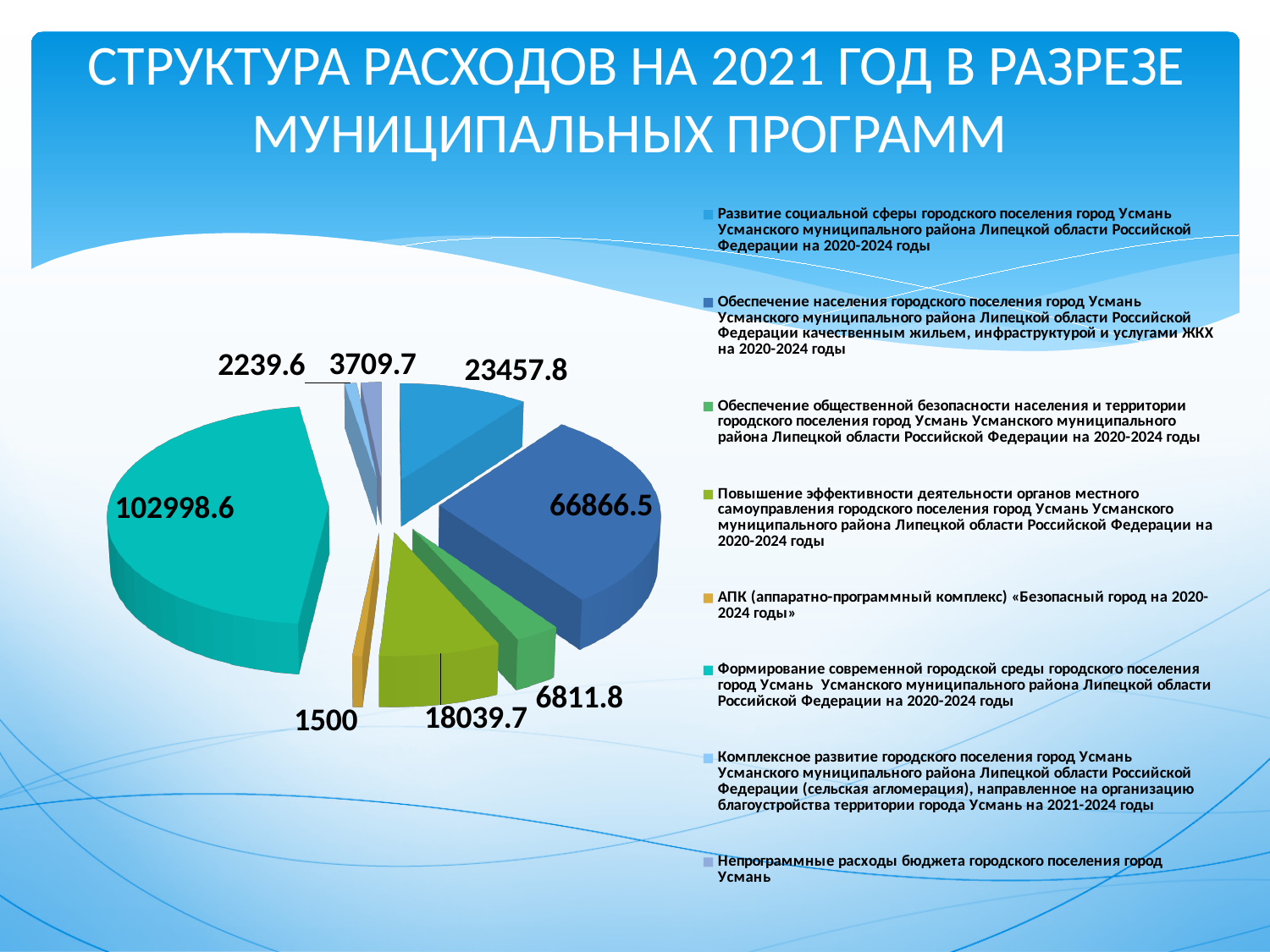
How many entries does the legend list? 8 What is the difference between the largest value (102998.6) and the second largest value (66866.5)? 36132.1 What is the value for «Развитие социальной сферы городского поселения город Усмань ... на 2020-2024 годы»? 23457.8 What type of chart is shown on the slide? Pie chart How many slices does the pie chart have? 8 What is the value for «Формирование современной городской среды городского поселения город Усмань ... на 2020-2024 годы»? 102998.6 What is the value for «Обеспечение населения городского поселения город Усмань ... качественным жильем, инфраструктурой и услугами ЖКХ на 2020-2024 годы»? 66866.5 What is the total of all values shown on the pie chart? 225623.7 What is the value for «АПК (аппаратно-программный комплекс) «Безопасный город на 2020-2024 годы»»? 1500 Which is larger: the value for «Повышение эффективности деятельности органов местного самоуправления ...» (18039.7) or the value for «Обеспечение общественной безопасности населения ...» (6811.8)? Повышение эффективности деятельности органов местного самоуправления (18039.7) Which category has the smallest slice of the pie? АПК (аппаратно-программный комплекс) «Безопасный город на 2020-2024 годы» Which program has the largest slice of the pie? Формирование современной городской среды городского поселения город Усмань Усманского муниципального района Липецкой области Российской Федерации на 2020-2024 годы